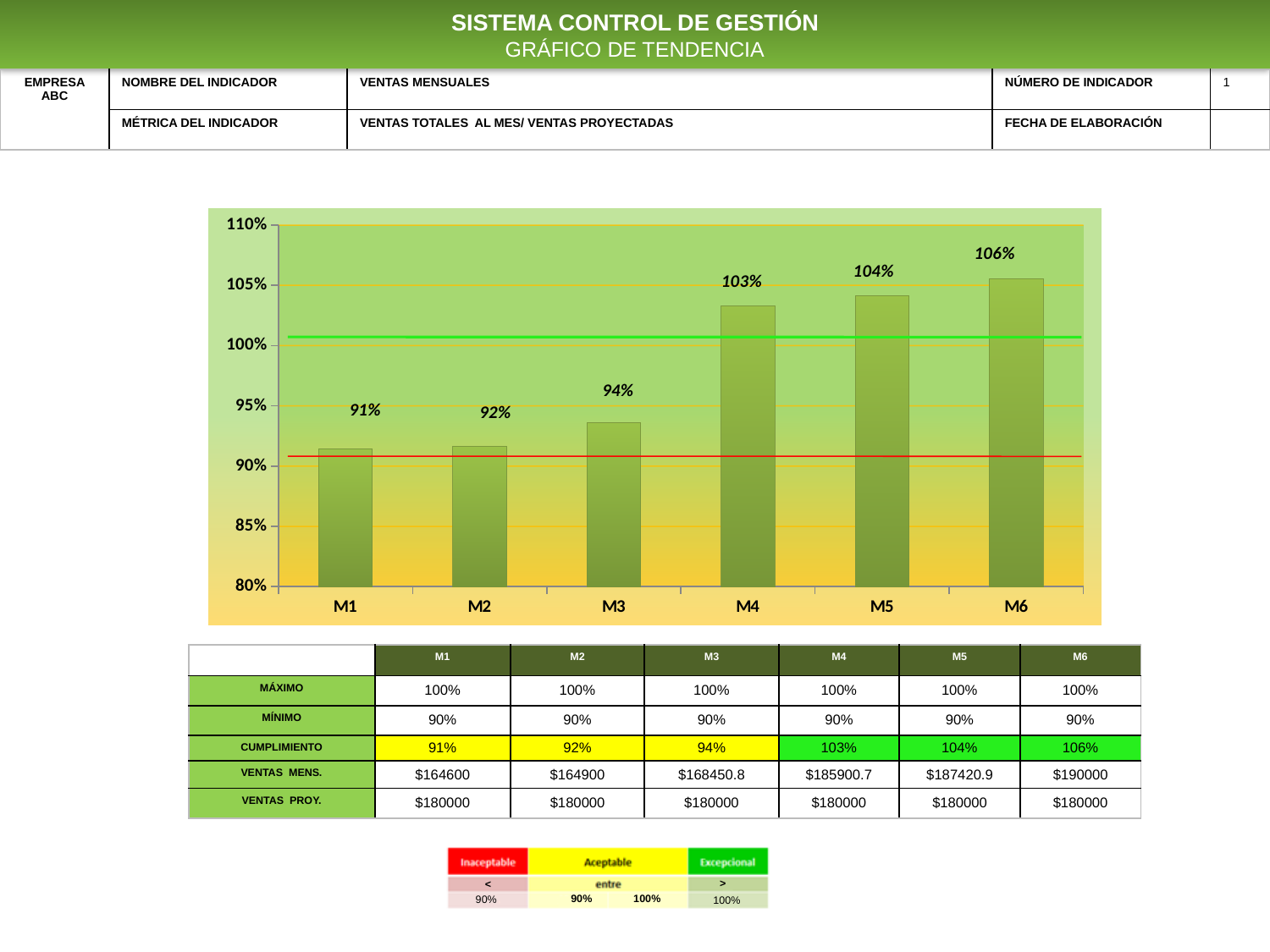
Which is larger in the bar chart, the value for M3 or the value for M5? M5 What is the value shown for M1 in the bar chart? 91% Is the value for M5 in the bar chart greater or less than 100%? greater Do the values in the bar chart rise or fall from M1 to M6? rise What is the difference between the values for M4 and M3 in the bar chart? 9% What is the difference between the values for M6 and M1 in the bar chart? 15% What is the value shown for M4 in the bar chart? 103% Which month has the lowest value in the bar chart? M1 Is the value for M3 in the bar chart greater or less than 100%? less How many months (categories) are plotted in the bar chart? 6 Which month has the highest value in the bar chart? M6 What kind of chart is shown on the slide? bar chart